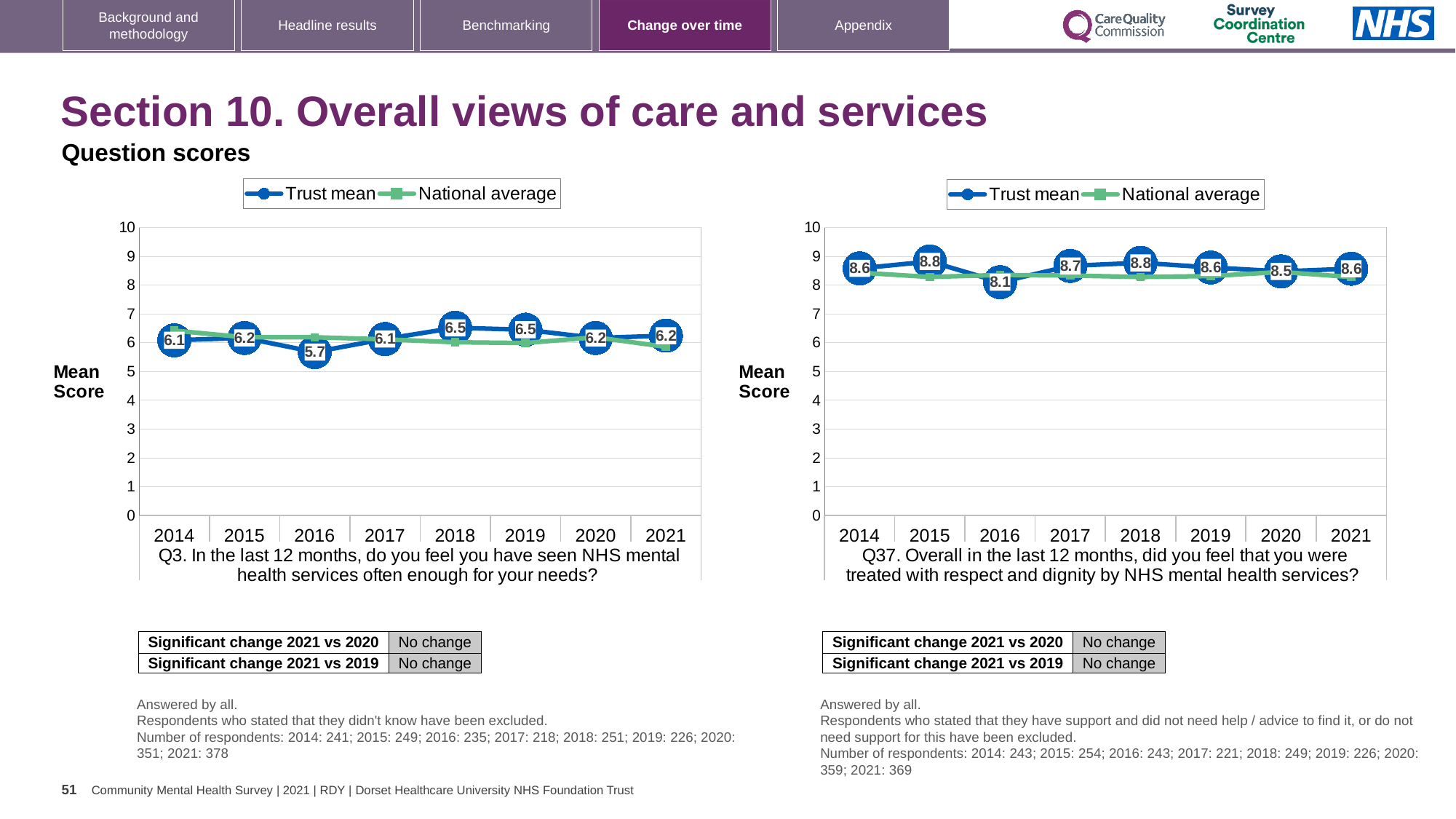
How many series does the legend of the Q37 chart on the right list? 2 In the Q3 chart on the left, what is the difference between the Trust mean in 2018 and in 2016? 0.8 In the Q37 chart on the right, what is the Trust mean for 2020? 8.5 In the Q37 chart on the right, which is larger: the Trust mean in 2017 or in 2016? 2017 In the Q37 chart on the right, is the National average for 2014 greater or less than 9? less What kind of chart is the Q3 chart on the left? Line chart In the Q3 chart on the left, what is the Trust mean for 2016? 5.7 How many years are shown on the x axis of the Q3 chart on the left? 8 In the Q37 chart on the right, what is the Trust mean for 2015? 8.8 In the Q3 chart on the left, what is the Trust mean for 2021? 6.2 In the Q3 chart on the left, which year has the lowest Trust mean? 2016 In the Q37 chart on the right, which year has the lowest Trust mean? 2016